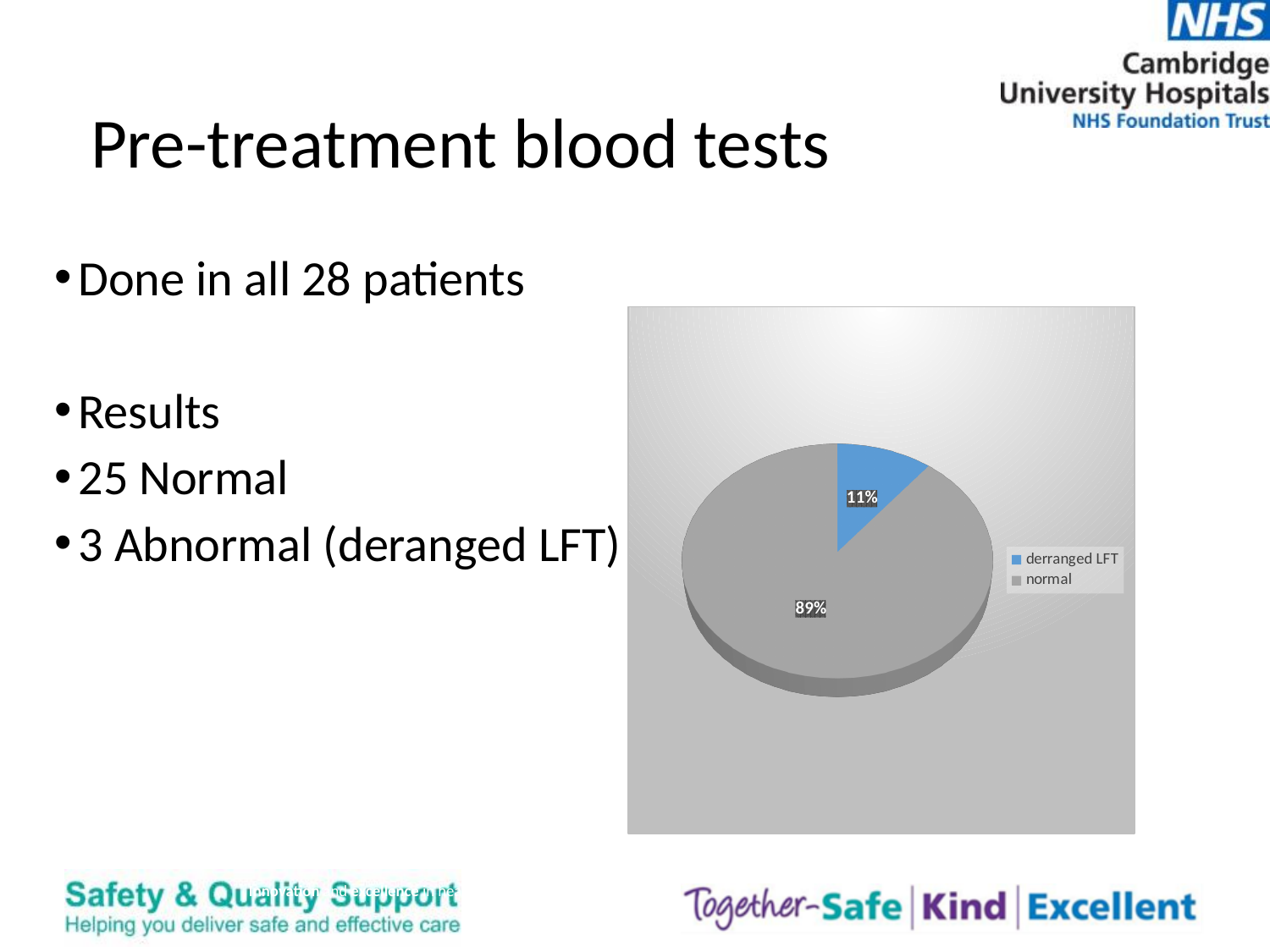
What colour is the 'normal' slice in the pie chart? grey How many slices does the pie chart have? 2 Which slice of the pie is the smallest? derranged LFT Which is larger, the 'normal' slice or the 'derranged LFT' slice? normal What percentage of the pie is labelled for the 'derranged LFT' slice? 11% What percentage of the pie is labelled for the 'normal' slice? 89% How many entries does the legend list? 2 Which slice of the pie is the largest? normal What kind of chart is shown on the slide? pie chart What colour is the 'derranged LFT' slice in the pie chart? blue What is the difference in percentage points between the 'normal' slice and the 'derranged LFT' slice? 78